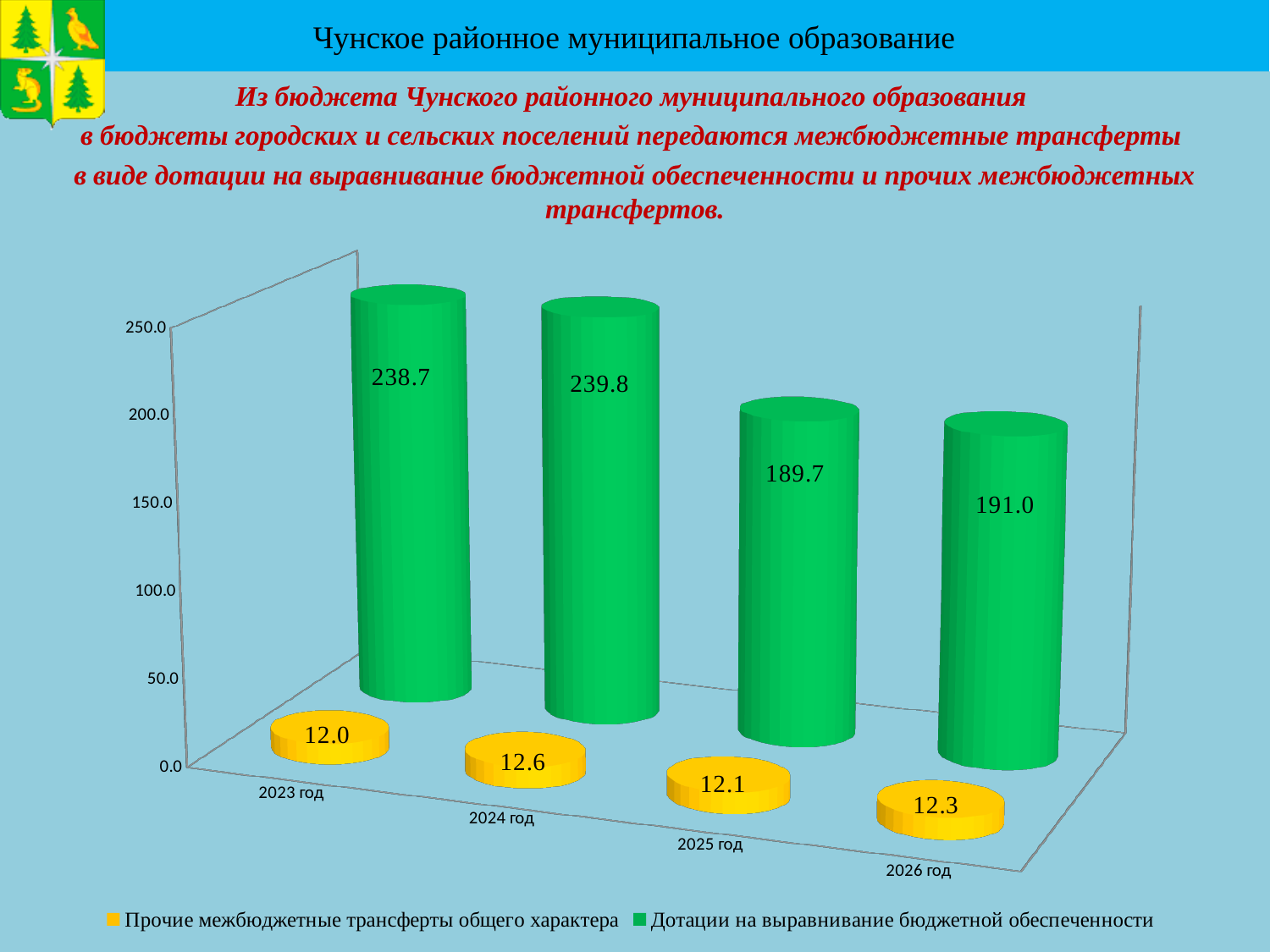
Which is larger: Прочие межбюджетные трансферты общего характера in 2023 год or in 2026 год? 2026 год What is the value of Прочие межбюджетные трансферты общего характера for 2025 год? 12.1 In which year is Дотации на выравнивание бюджетной обеспеченности the highest? 2024 год What is the value of Дотации на выравнивание бюджетной обеспеченности for 2023 год? 238.7 What is the difference between the Дотации на выравнивание бюджетной обеспеченности values for 2024 год and 2025 год? 50.1 In which year is Прочие межбюджетные трансферты общего характера the highest? 2024 год In which year is Дотации на выравнивание бюджетной обеспеченности the lowest? 2025 год What kind of chart is shown on the slide? bar chart Which colour represents Прочие межбюджетные трансферты общего характера in the chart? yellow How many years are shown on the x axis of the chart? 4 How many series does the legend list? 2 What is the value of Дотации на выравнивание бюджетной обеспеченности for 2026 год? 191.0